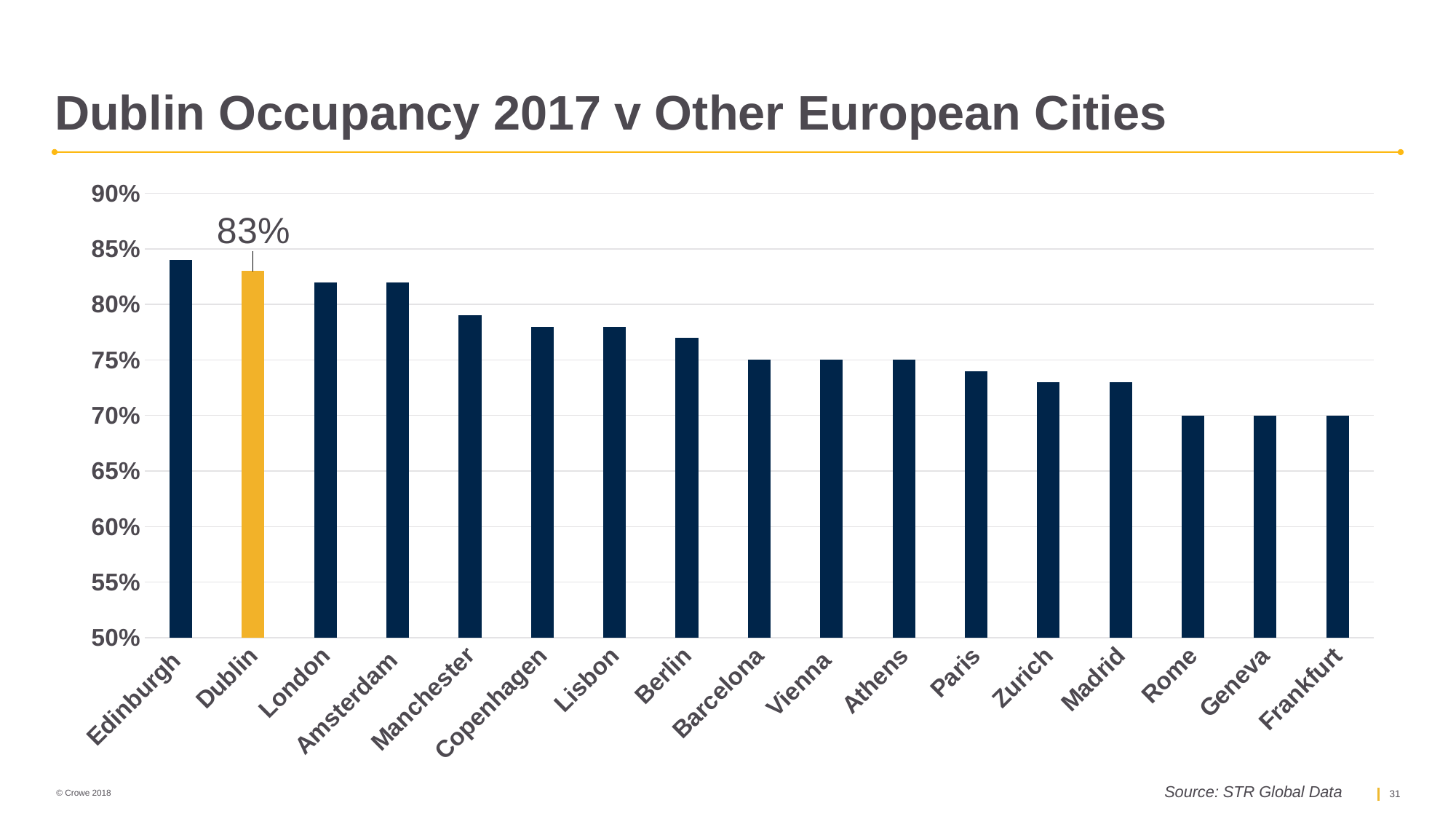
Which has the higher occupancy, London or Madrid? London Which city has the highest occupancy in the chart? Edinburgh Is the value for Copenhagen greater or less than 80%? less Is the value for Manchester greater or less than 75%? greater What kind of chart is shown on the slide? Bar chart What is the occupancy value for Rome? 70% Is the value for Zurich greater or less than 75%? less Which city's bar is highlighted in a different colour (yellow) from the others? Dublin Do the occupancy values rise or fall from left to right across the chart? Fall What is the occupancy value for Vienna? 75% How many cities are shown in the chart? 17 What is the occupancy value shown for Dublin? 83%